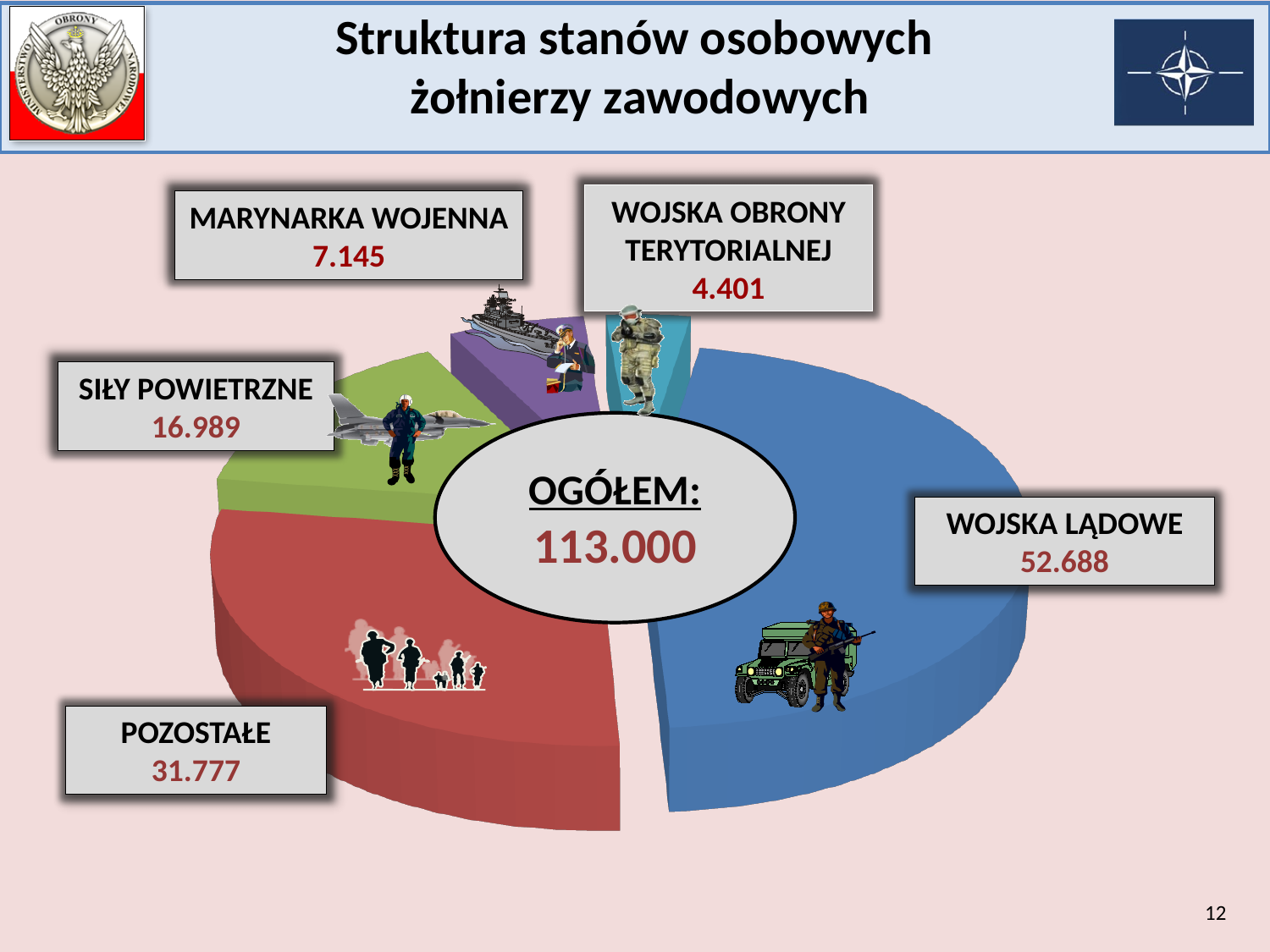
What is the value for Siły Powietrzne? 16.989 What is the value for Pozostałe? 31.777 How many categories does the pie chart show? 5 What is the value for Wojska Obrony Terytorialnej? 4.401 What type of chart is shown on the slide? pie chart Which is larger, Siły Powietrzne or Marynarka Wojenna? Siły Powietrzne What is the value for Wojska Lądowe? 52.688 Which category has the largest value? Wojska Lądowe What is the difference between Wojska Lądowe and Pozostałe? 20.911 What is the value for Marynarka Wojenna? 7.145 Which category has the smallest value? Wojska Obrony Terytorialnej What total (OGÓŁEM) is shown in the centre of the chart? 113.000